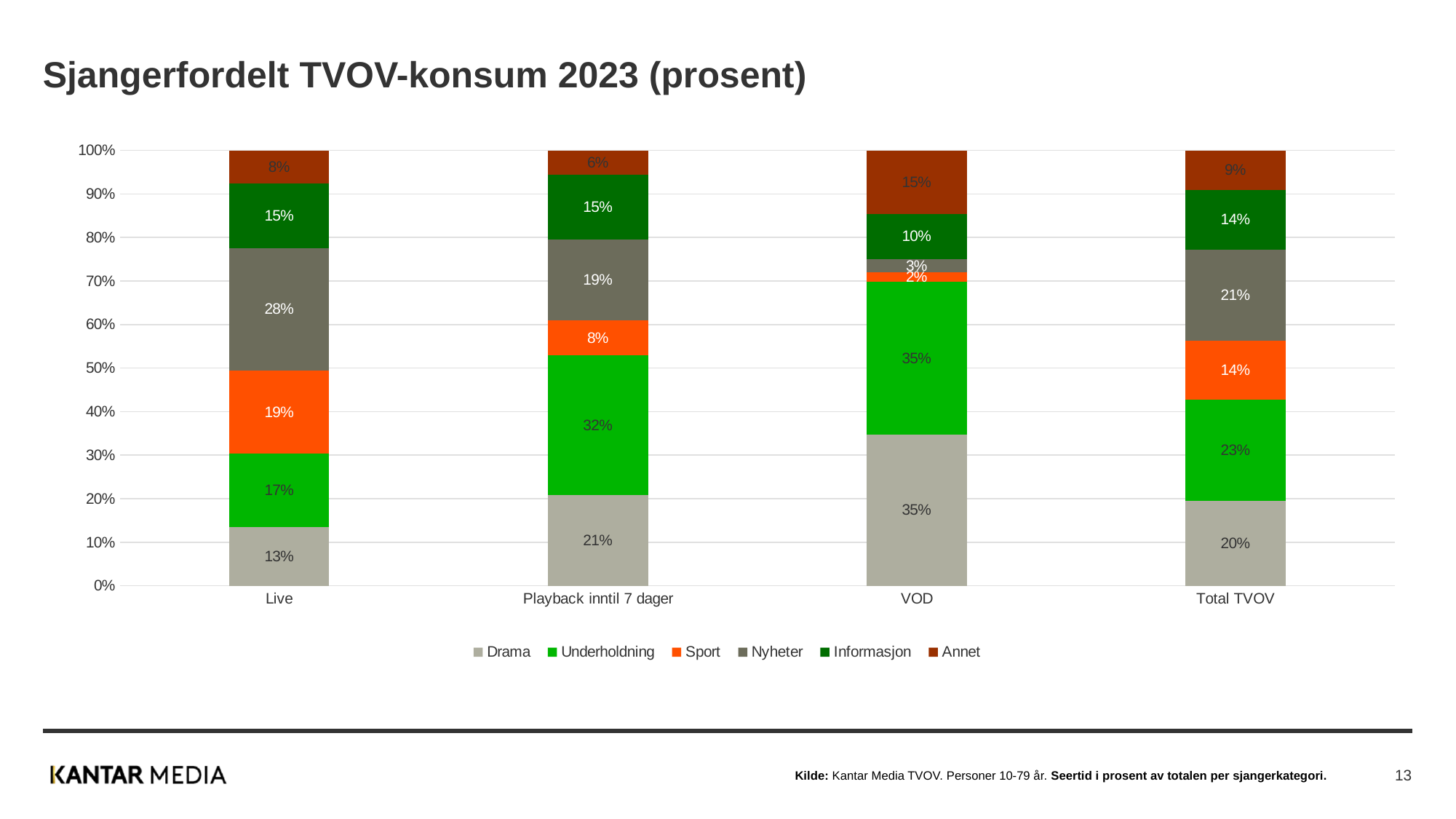
What is the Sport share for Playback inntil 7 dager? 8% What is the Drama share for VOD? 35% Which category has the highest Annet share? VOD What is the difference between the Sport share for Live and the Sport share for Total TVOV? 5% Which category has the lowest Sport share? VOD What is the Nyheter share for Live? 28% How many series does the legend list? 6 What kind of chart is shown on the slide? Stacked bar chart What is the Underholdning share for Total TVOV? 23% Which is larger: the Drama share for Playback inntil 7 dager or the Drama share for Live? Playback inntil 7 dager How many categories are shown on the x axis? 4 What is the title of the chart? Sjangerfordelt TVOV-konsum 2023 (prosent)